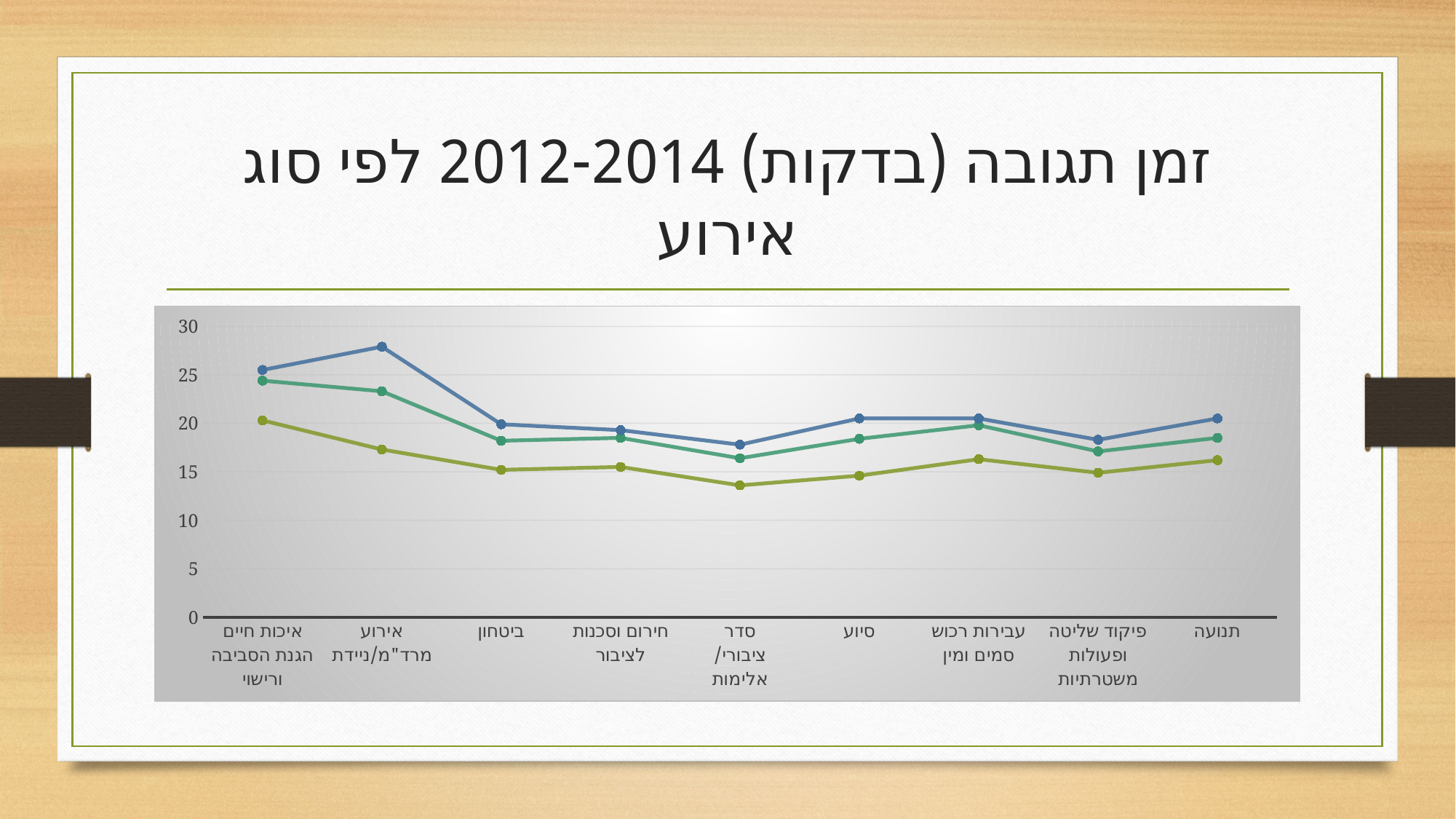
For ביטחון, which line has the larger value, the blue line or the green line? the blue line How many lines are plotted on the chart? 3 For the green line, which category has the highest value? איכות חיים הגנת הסביבה ורישוי Is the value of the green line for סדר ציבורי/אלימות greater or less than 15? less How many event-type categories are shown on the x axis? 9 Is the value of the blue line for אירוע מרד"מ/ניידת greater or less than 25? greater Is the value of the teal line for איכות חיים הגנת הסביבה ורישוי greater or less than 20? greater What is the title of the slide? זמן תגובה (בדקות) 2012-2014 לפי סוג אירוע For the green line, which category has the lowest value? סדר ציבורי/אלימות For the blue line, which category has the highest value? אירוע מרד"מ/ניידת What kind of chart is shown on the slide? line chart